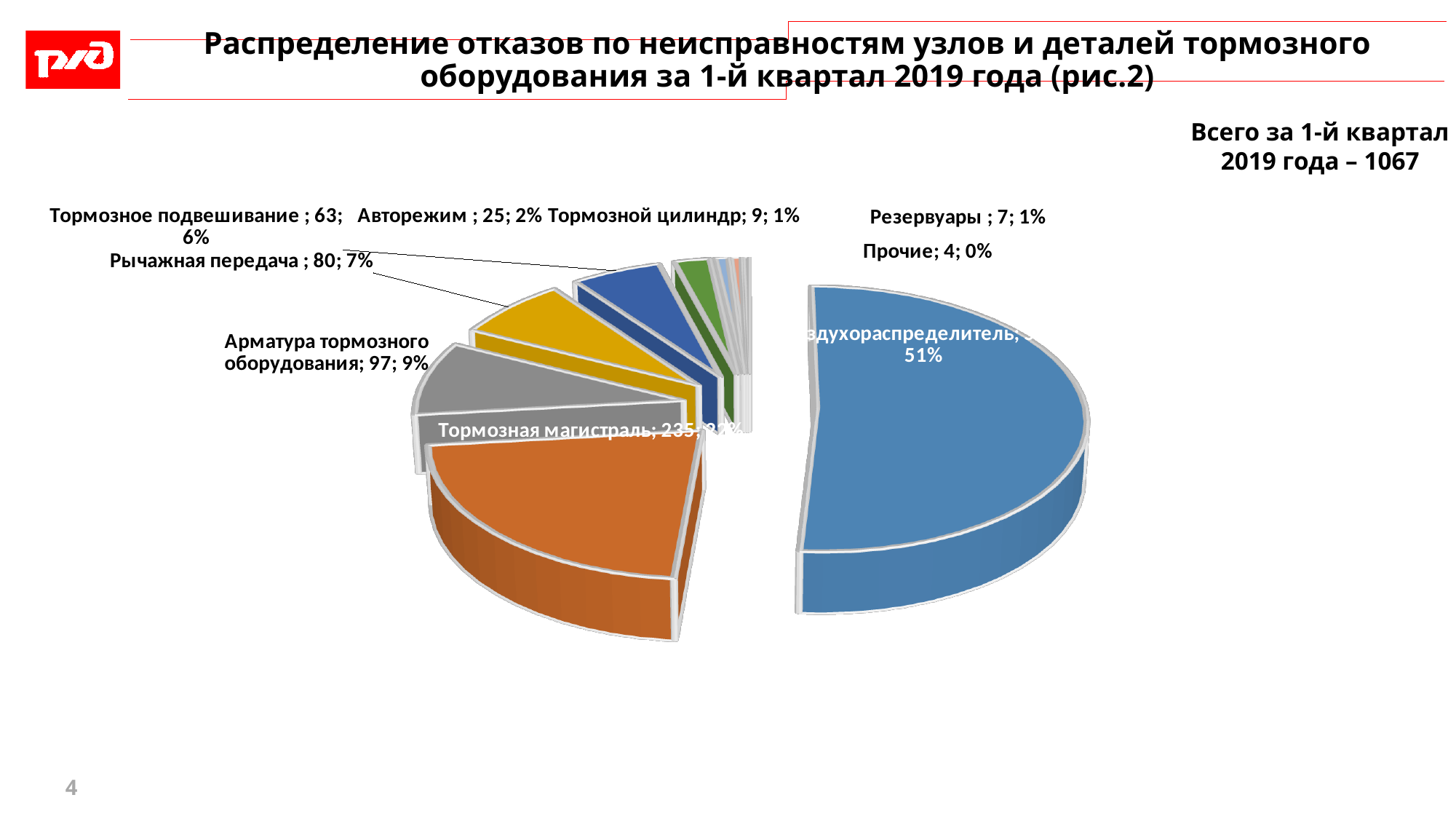
How many categories are labelled in the pie chart? 9 What kind of chart is shown on the slide? pie chart Which is larger, the value for Тормозное подвешивание or the value for Авторежим? Тормозное подвешивание What is the value for Тормозная магистраль? 235 Which category has the largest slice of the pie? Воздухораспределитель What is the difference between the values for Арматура тормозного оборудования and Рычажная передача? 17 What share of the pie does Тормозное подвешивание take? 6% What is the value for Арматура тормозного оборудования? 97 Which category has the smallest slice of the pie? Прочие What is the value for Авторежим? 25 How many failures are attributed to Рычажная передача? 80 What share of the pie does Воздухораспределитель take? 51%